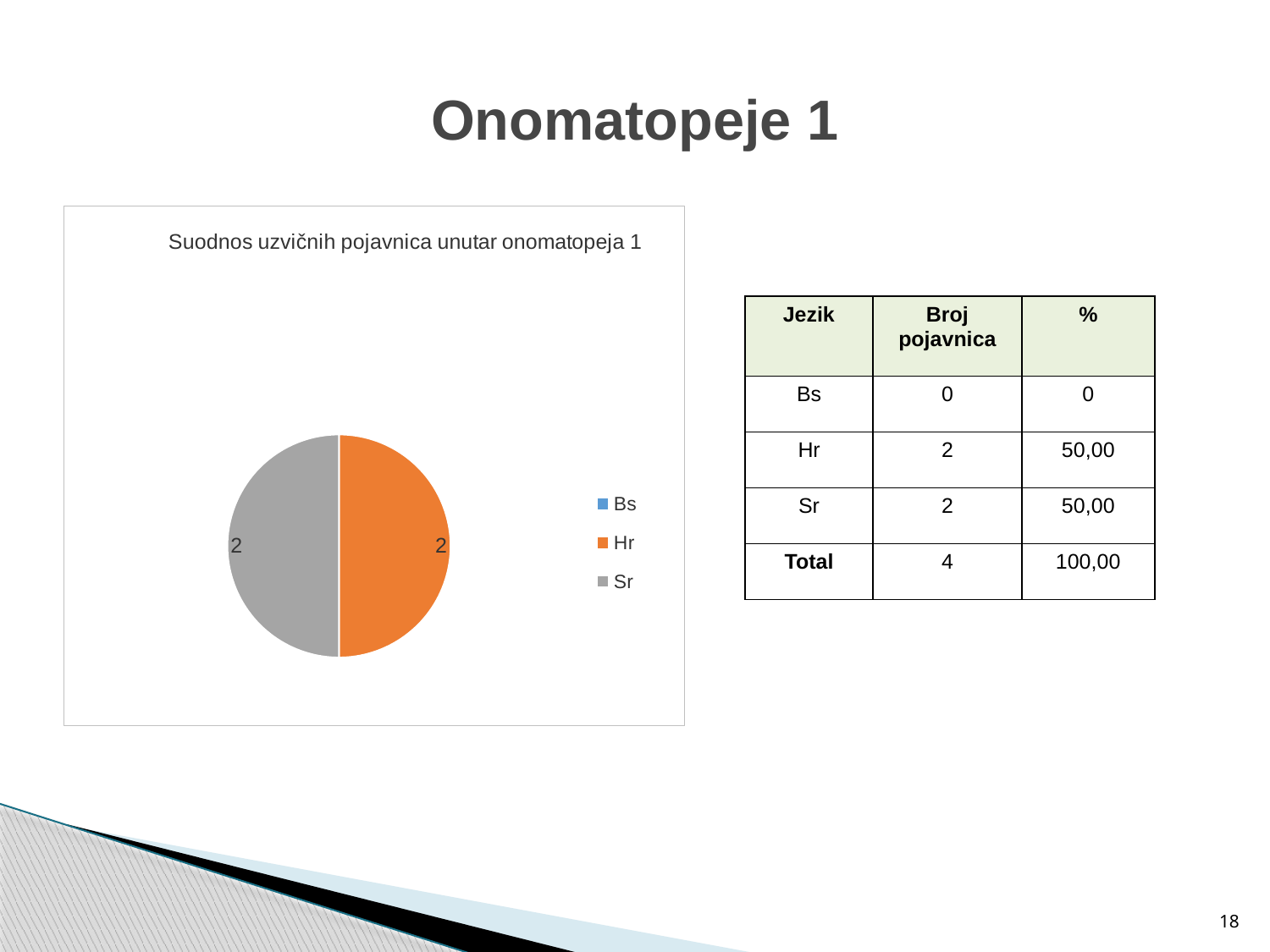
What is the value shown for Hr in the pie chart? 2 What is the total of the values labelled on the pie chart? 4 How many entries does the chart's legend list? 3 What share of the pie does the Sr slice represent? 50% What is the difference between the values for Hr and Sr in the pie chart? 0 What is the value shown for Sr in the pie chart? 2 What share of the pie does the Hr slice represent? 50% Which legend entry has no visible slice in the pie chart? Bs Are the values for Hr and Sr in the pie chart equal? yes What is the title of the chart? Suodnos uzvičnih pojavnica unutar onomatopeja 1 How many slices are visible in the pie chart? 2 What kind of chart is shown on the slide? pie chart